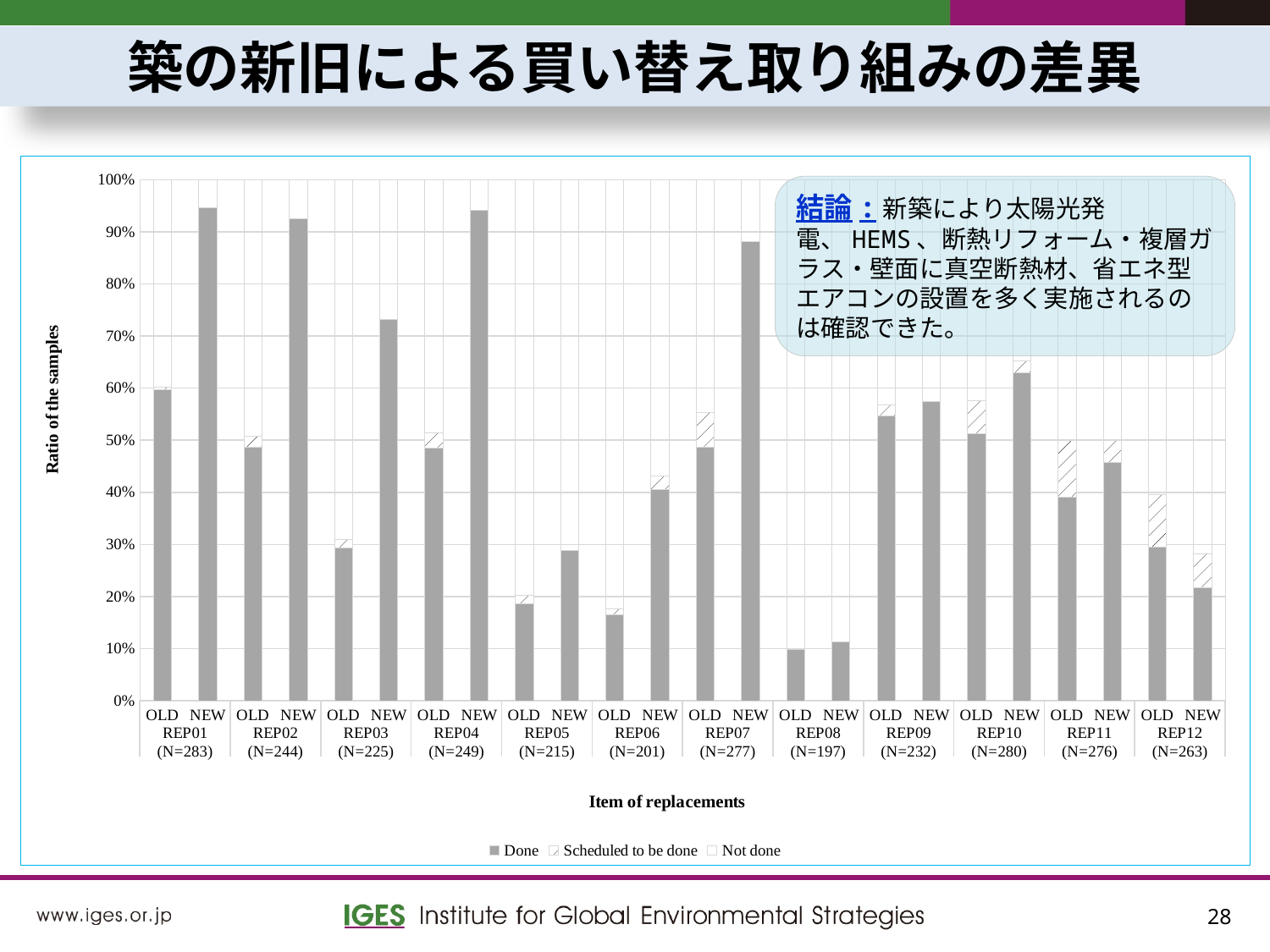
How many replacement items (REP01 to REP12) are shown on the x axis? 12 What is the title of the vertical axis? Ratio of the samples Is the Done value for OLD REP08 greater or less than 20%? less Among the OLD bars, which replacement item has the lowest Done share? REP08 For REP12, which has the larger Done share, OLD or NEW? OLD Is the Done value for NEW REP07 greater or less than 80%? greater What kind of chart is shown on the slide? Stacked bar chart How many series does the legend list? 3 Is the Done value for NEW REP01 greater or less than 90%? greater What is the sample size (N) shown for REP01? N=283 For REP03, which has the larger Done share, OLD or NEW? NEW